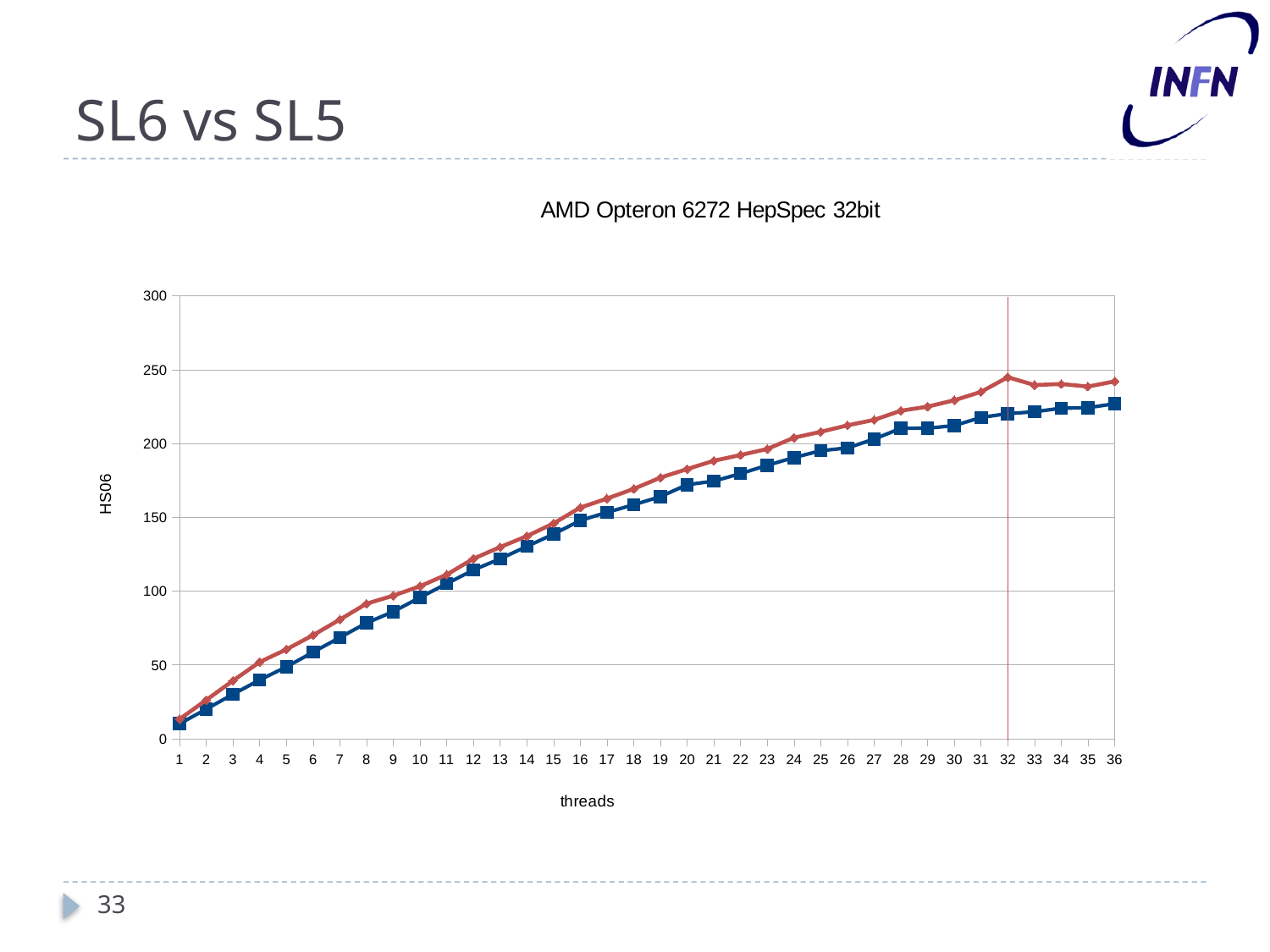
What kind of chart is shown on the slide? line chart Is the value of the red line at 32 threads greater or less than 200? greater What is the label of the y axis? HS06 Is the value of the red line at 1 thread greater or less than 50? less How many lines are plotted on the chart? 2 Do the HS06 values generally rise or fall as the number of threads increases? rise At which number of threads does the blue line reach its highest value? 36 Is the value of the blue line at 20 threads greater or less than 150? greater How many thread counts are plotted along the x axis? 36 What is the title of the chart? AMD Opteron 6272 HepSpec 32bit At 8 threads, which line has the higher value, the red line or the blue line? the red line